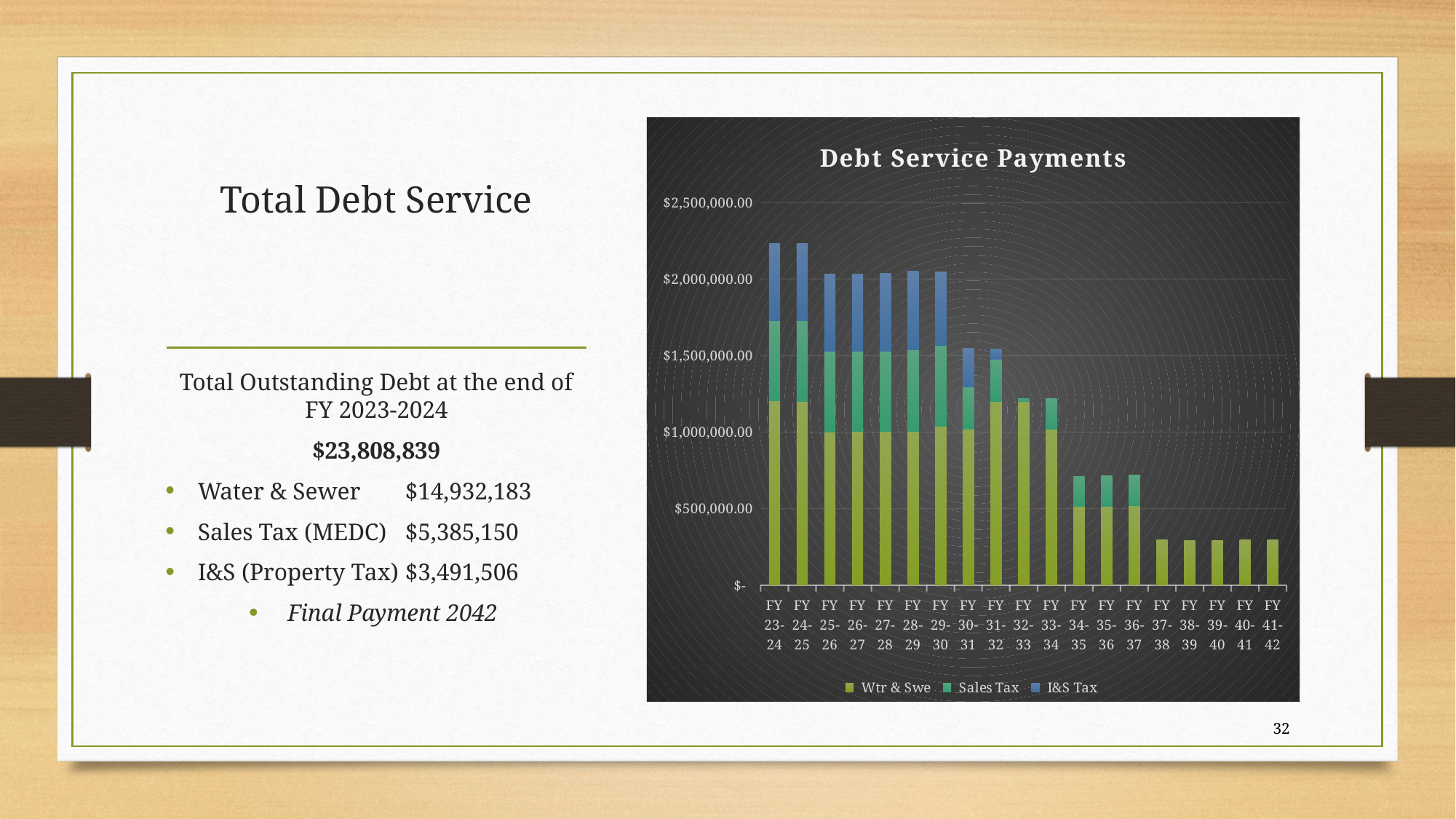
How many fiscal years are plotted along the x axis of the Debt Service Payments chart? 19 Is the total debt service payment for FY 23-24 greater or less than $2,000,000.00? greater Which has the larger total debt service payment, FY 23-24 or FY 41-42? FY 23-24 Do the total debt service payments generally rise or fall from FY 23-24 to FY 41-42? fall Is the total debt service payment for FY 37-38 greater or less than $500,000.00? less Is the total debt service payment for FY 34-35 greater or less than $500,000.00? greater Which series are listed in the legend of the Debt Service Payments chart? Wtr & Swe, Sales Tax, I&S Tax What kind of chart is shown on the slide? Stacked bar chart Which has the larger total debt service payment, FY 33-34 or FY 34-35? FY 33-34 How many series does the legend of the Debt Service Payments chart list? 3 What is the title of the chart on the slide? Debt Service Payments